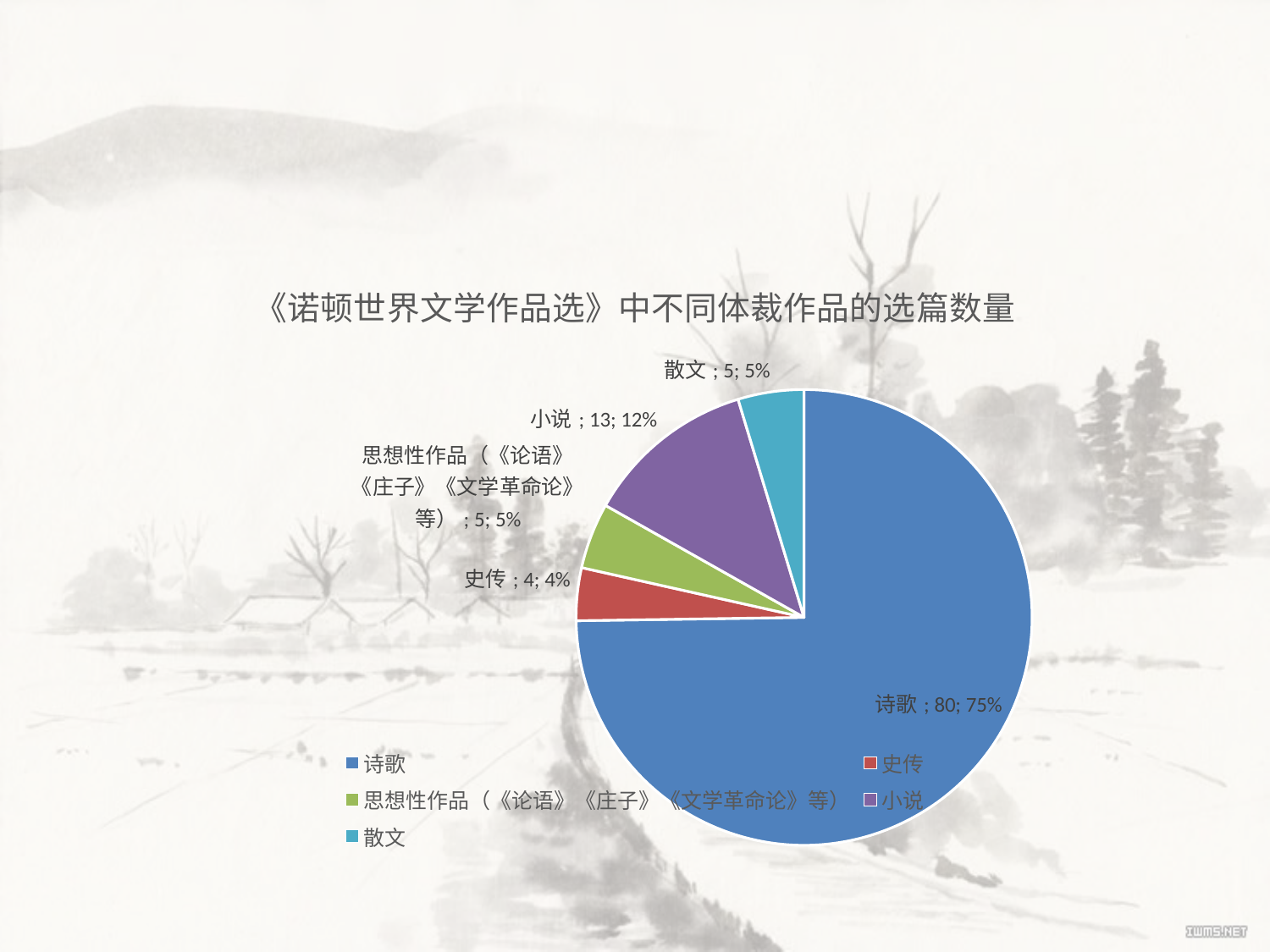
What is the difference between the values for 诗歌 and 小说? 67 What kind of chart is shown on the slide? pie chart What is the title of the chart? 《诺顿世界文学作品选》中不同体裁作品的选篇数量 What is the value for 小说? 13 Which category has the largest slice? 诗歌 What is the value for 诗歌? 80 What share of the pie does 小说 take? 12% How many entries does the legend list? 5 Which category has the smallest slice? 史传 How many slices does the pie chart have? 5 What is the value for 史传? 4 What share of the pie does 诗歌 take? 75%